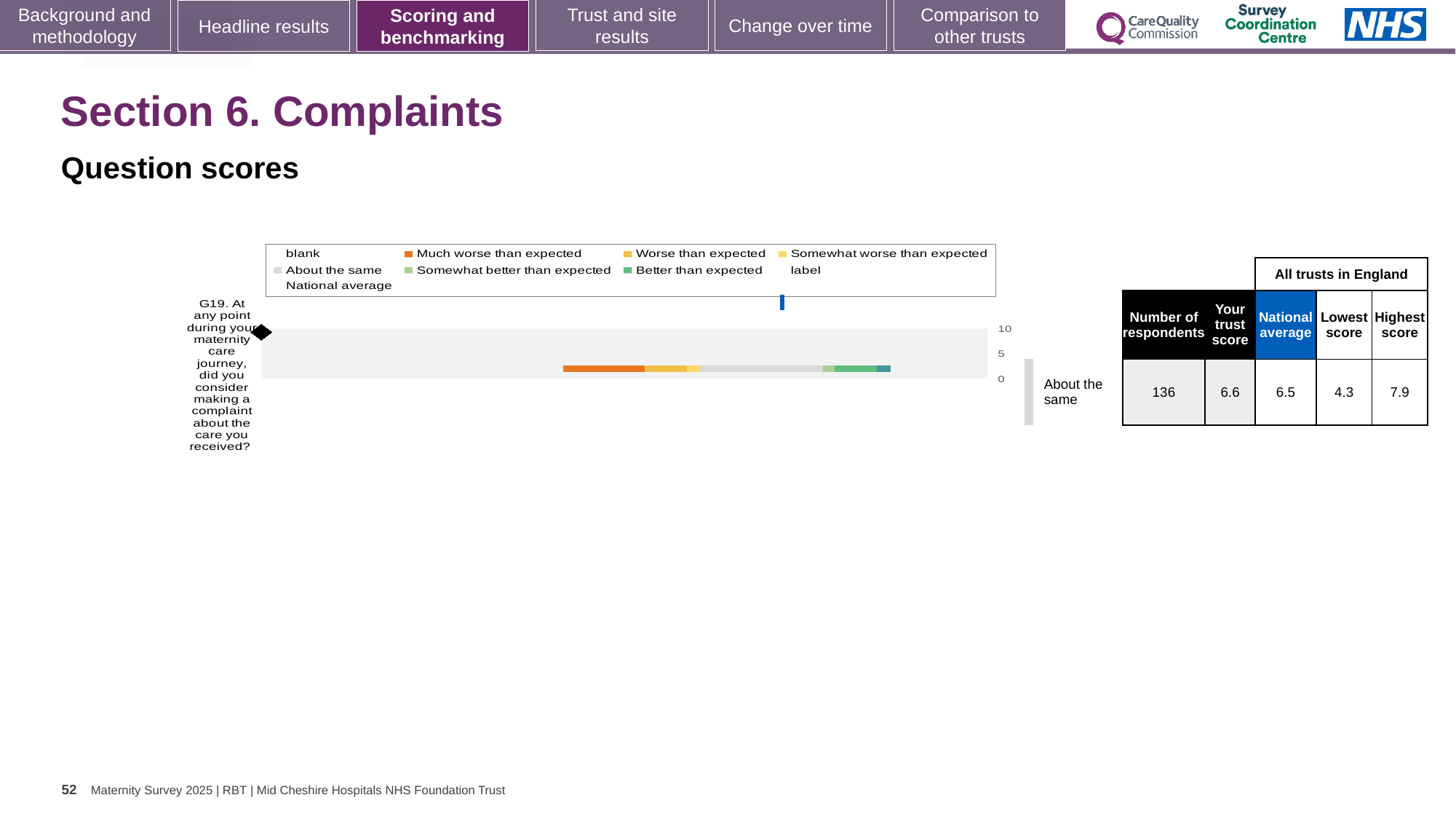
Which question number is plotted in the chart? G19 What colour does the legend use for 'Much worse than expected'? orange In the table next to the chart, what is the difference between the highest score and the lowest score for G19? 3.6 In the table next to the chart, what is the lowest score among all trusts in England for G19? 4.3 In the table next to the chart, what is your trust score for G19? 6.6 In the table next to the chart, which is larger for G19: your trust score or the national average? Your trust score In the table next to the chart, what is the number of respondents for G19? 136 How many questions (categories) are plotted in the chart? 1 In the table next to the chart, what is the national average for G19? 6.5 In the table next to the chart, what is the highest score among all trusts in England for G19? 7.9 What kind of chart is shown on the slide? bar chart What benchmark category is shown for G19 next to the chart? About the same